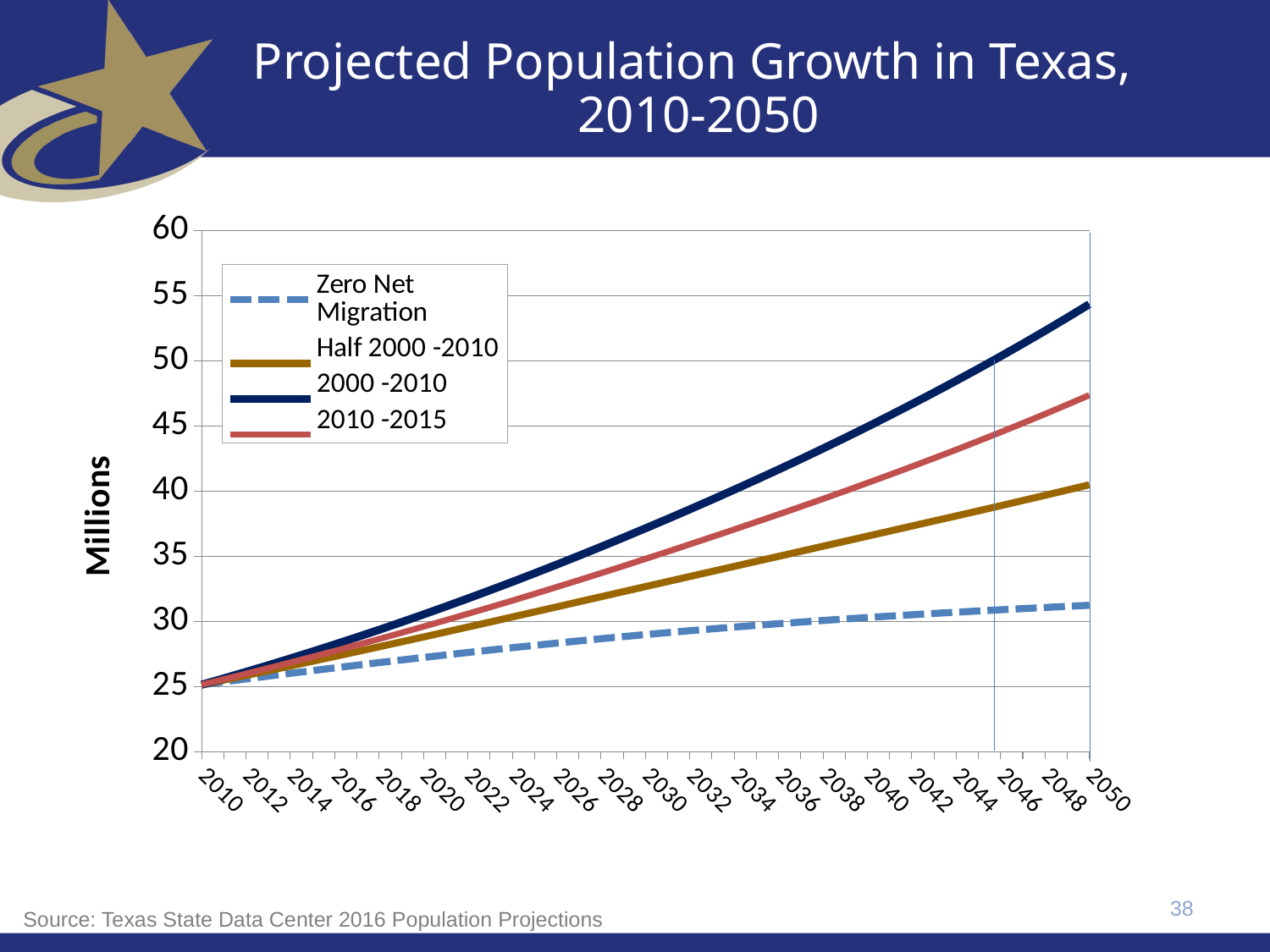
Which series has the lowest value in 2050? Zero Net Migration Which series reaches the highest value in 2050? 2000 -2010 Is the value for the 2000 -2010 series in 2050 greater or less than 50? greater What is the title of the chart? Projected Population Growth in Texas, 2010-2050 How many series does the legend list? 4 In 2050, which series is larger: Half 2000 -2010 or 2010 -2015? 2010 -2015 Is the value for the Zero Net Migration series in 2030 greater or less than 30? less Is the value for the 2010 -2015 series in 2050 greater or less than 45? greater Do the values of the 2000 -2010 series rise or fall from 2010 to 2050? rise What is the label on the vertical axis? Millions What kind of chart is shown on the slide? line chart